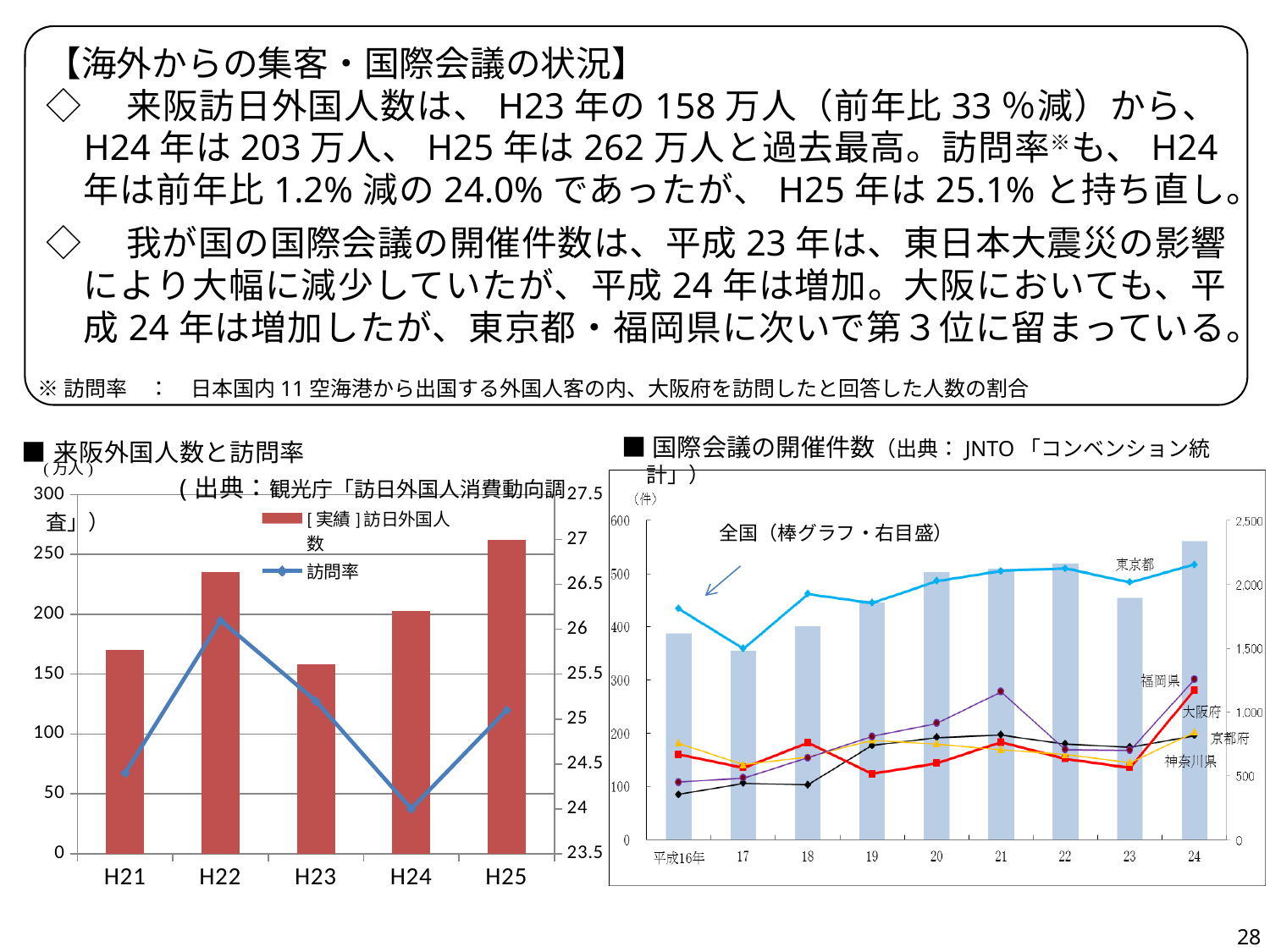
In the left chart (来阪外国人数と訪問率), which is larger, the 訪日外国人数 bar for H22 or for H24? H22 In the right chart (国際会議の開催件数), how many years are shown on the x axis? 9 In the left chart (来阪外国人数と訪問率), which year has the shortest 訪日外国人数 bar? H23 In the right chart (国際会議の開催件数), is the 全国 bar for 平成24年 greater or less than 2,000 on the right axis? greater In the right chart (国際会議の開催件数), which year has the tallest 全国 bar? 平成24年 In the left chart (来阪外国人数と訪問率), which year has the tallest 訪日外国人数 bar? H25 In the left chart (来阪外国人数と訪問率), in which year is the 訪問率 line at its lowest point? H24 In the left chart (来阪外国人数と訪問率), how many series does the legend list? 2 In the left chart (来阪外国人数と訪問率), what kind of chart is used for the 訪日外国人数 series? bar chart In the left chart (来阪外国人数と訪問率), how many years are shown on the x axis? 5 In the left chart (来阪外国人数と訪問率), in which year is the 訪問率 line at its highest point? H22 In the left chart (来阪外国人数と訪問率), is the 訪日外国人数 bar for H25 greater or less than 250? greater